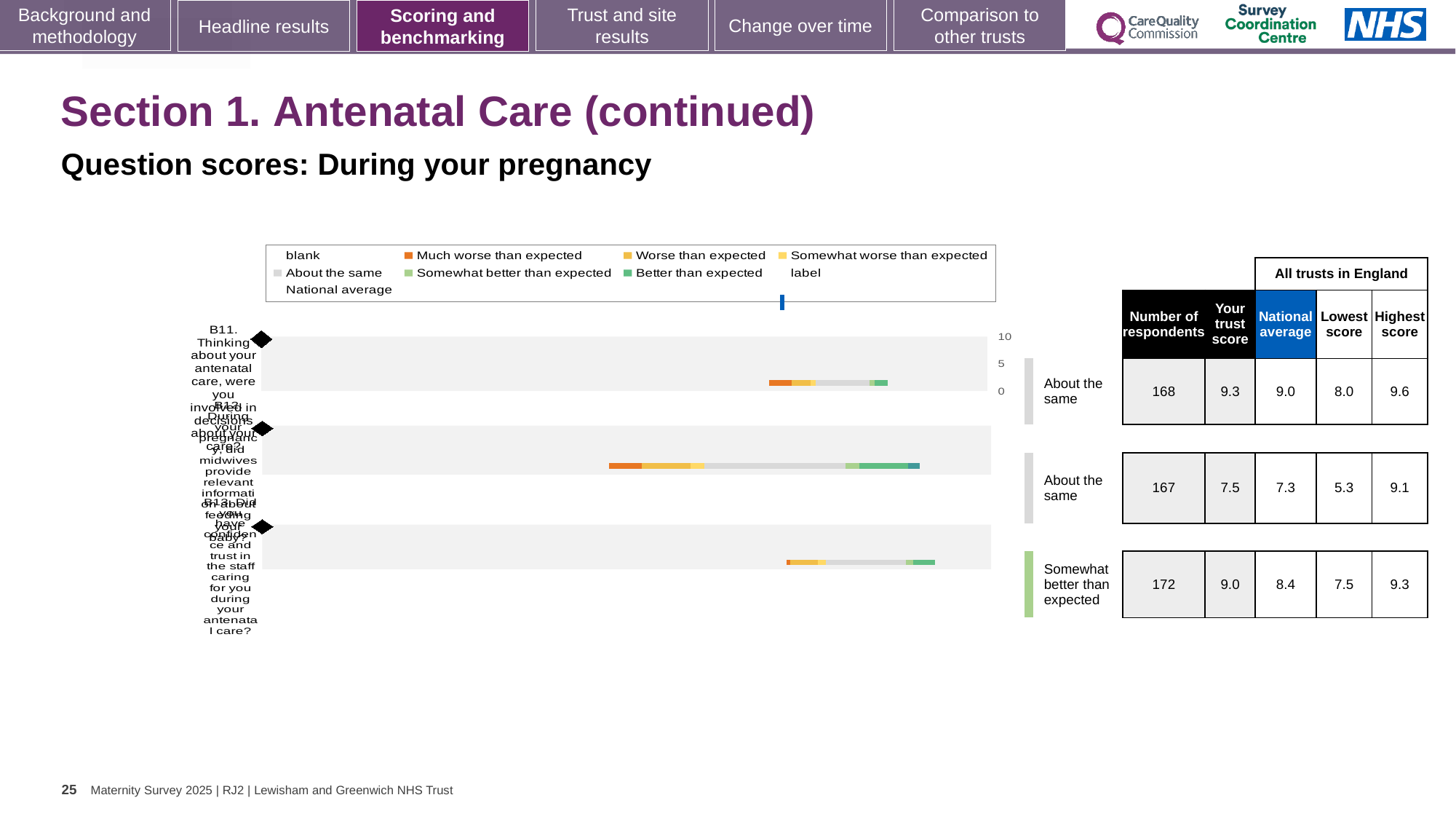
Which question has the highest number of respondents in the table next to the chart? B13 In the table next to the chart, what is 'Your trust score' for question B12? 7.5 In the table next to the chart, what is the national average for question B13? 8.4 What kind of chart is shown on the slide? bar chart For question B13, what is the difference between 'Your trust score' and the national average in the table? 0.6 How many entries does the chart legend list? 9 What colour does the legend use for 'Much worse than expected'? orange What colour does the legend use for 'Better than expected'? green In the table next to the chart, what is the number of respondents for question B11? 168 Which is larger for question B11: 'Your trust score' or the national average? Your trust score How many question bars are plotted in the chart? 3 Which question has the lowest 'Your trust score' in the table next to the chart? B12